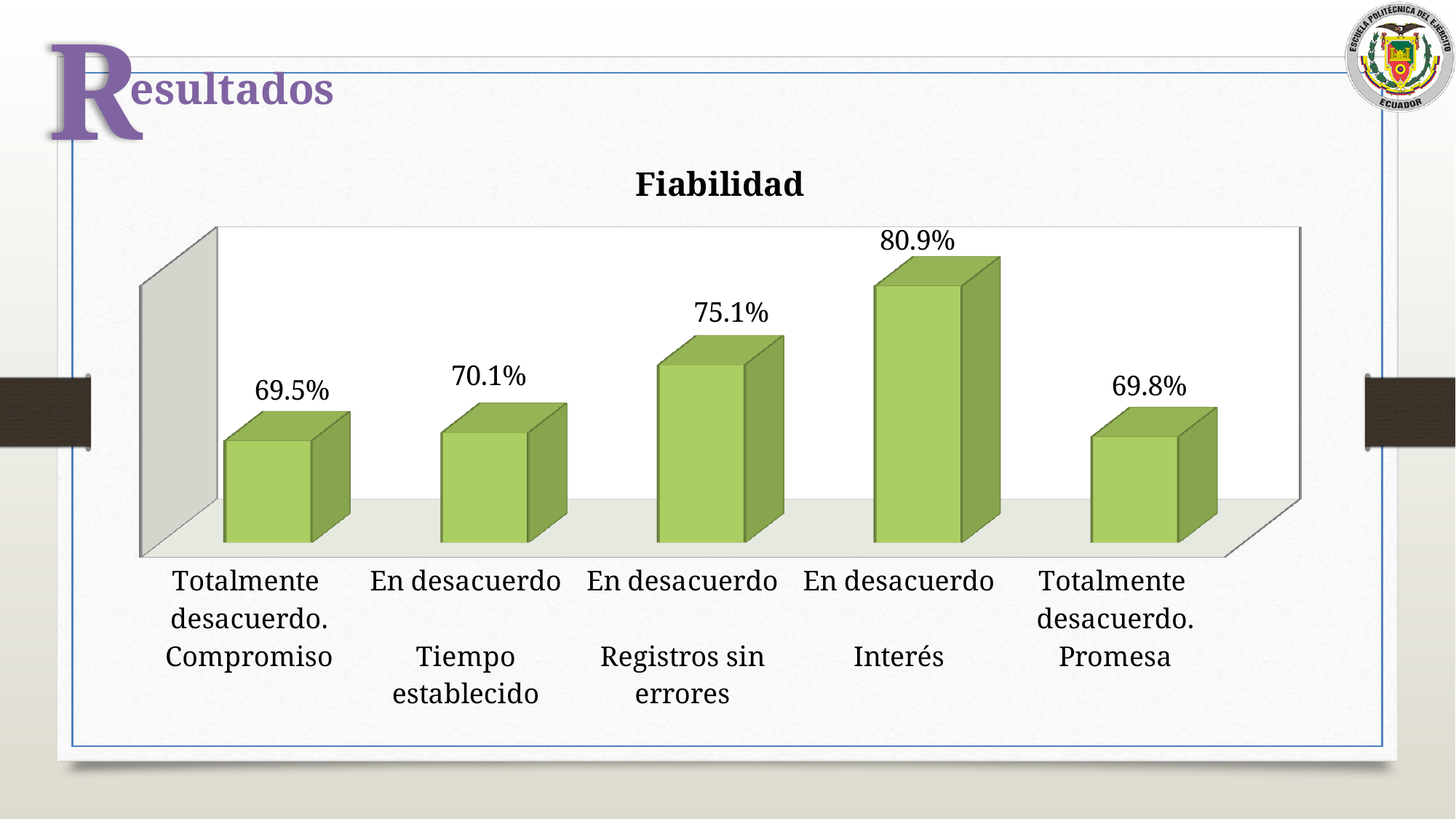
What is the difference between the values for Interés and Registros sin errores? 5.8% What is the value for Registros sin errores? 75.1% What is the value for Tiempo establecido? 70.1% What is the value for Interés in the Fiabilidad chart? 80.9% Which category has the highest value in the Fiabilidad chart? Interés What is the value for Promesa? 69.8% What kind of chart is shown on the slide? Bar chart Which category has the lowest value in the Fiabilidad chart? Compromiso What is the title of the chart? Fiabilidad How many categories are shown in the Fiabilidad chart? 5 Which is larger, the value for Interés or the value for Tiempo establecido? Interés What is the difference between the values for Registros sin errores and Compromiso? 5.6%